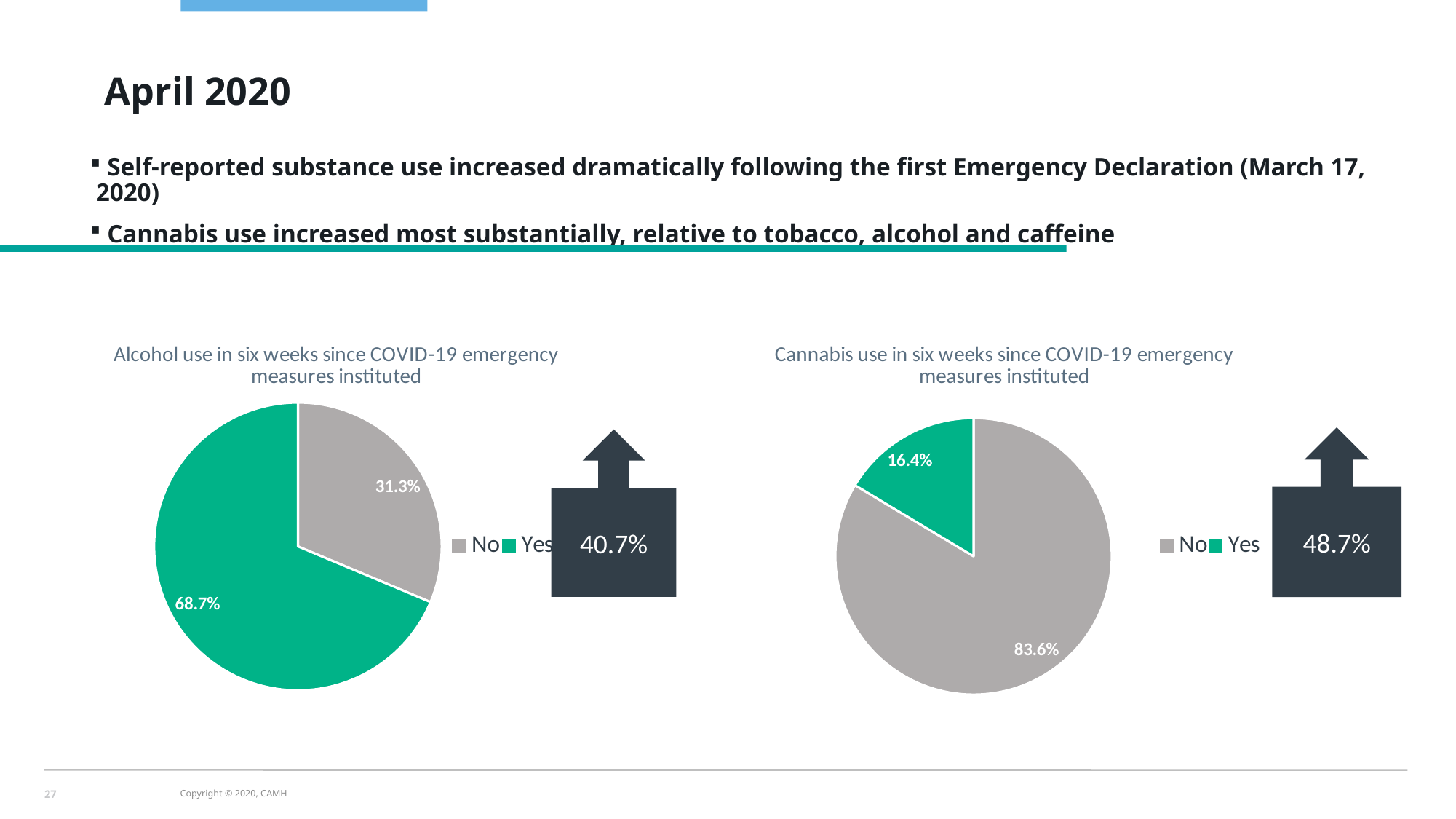
In the Alcohol use chart on the left, which slice is the largest? Yes In the Cannabis use chart on the right, what is the difference between the No and Yes percentages? 67.2% In the Cannabis use chart on the right, which slice is the smallest? Yes In the 'Cannabis use in six weeks since COVID-19 emergency measures instituted' chart, what percentage answered Yes? 16.4% In the 'Cannabis use in six weeks since COVID-19 emergency measures instituted' chart, what percentage answered No? 83.6% In the Cannabis use chart on the right, what colour is the Yes slice? Green What type of chart is the 'Cannabis use in six weeks since COVID-19 emergency measures instituted' chart? Pie chart In the 'Alcohol use in six weeks since COVID-19 emergency measures instituted' chart, what percentage answered No? 31.3% In the Alcohol use chart on the left, what is the difference between the Yes and No percentages? 37.4% How many slices does the Alcohol use pie chart on the left have? 2 In the 'Alcohol use in six weeks since COVID-19 emergency measures instituted' chart, what percentage answered Yes? 68.7% Is the Yes share larger in the Alcohol use chart or in the Cannabis use chart? Alcohol use chart